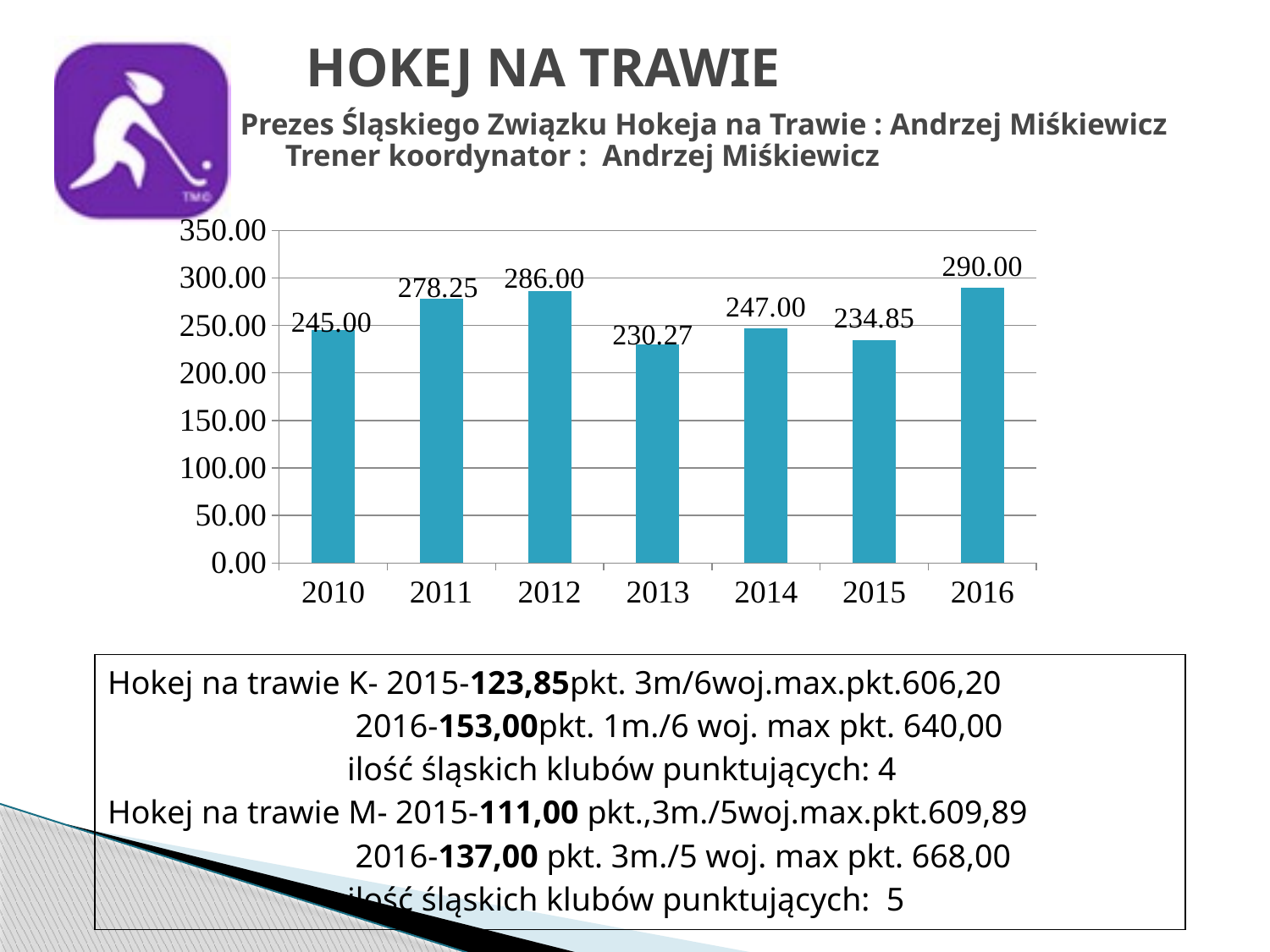
What is the value for 2013? 230.27 What kind of chart is shown on the slide? bar chart What is the value for 2015? 234.85 Which is larger, the value for 2014 or the value for 2015? 2014 Which year has the highest value? 2016 What is the difference between the values for 2012 and 2011? 7.75 How many years are shown on the x axis? 7 What is the difference between the values for 2016 and 2013? 59.73 What is the value for 2010? 245.00 Is the value for 2012 greater or less than 250.00? greater Does the value rise or fall from 2012 to 2013? fall Which year has the lowest value? 2013